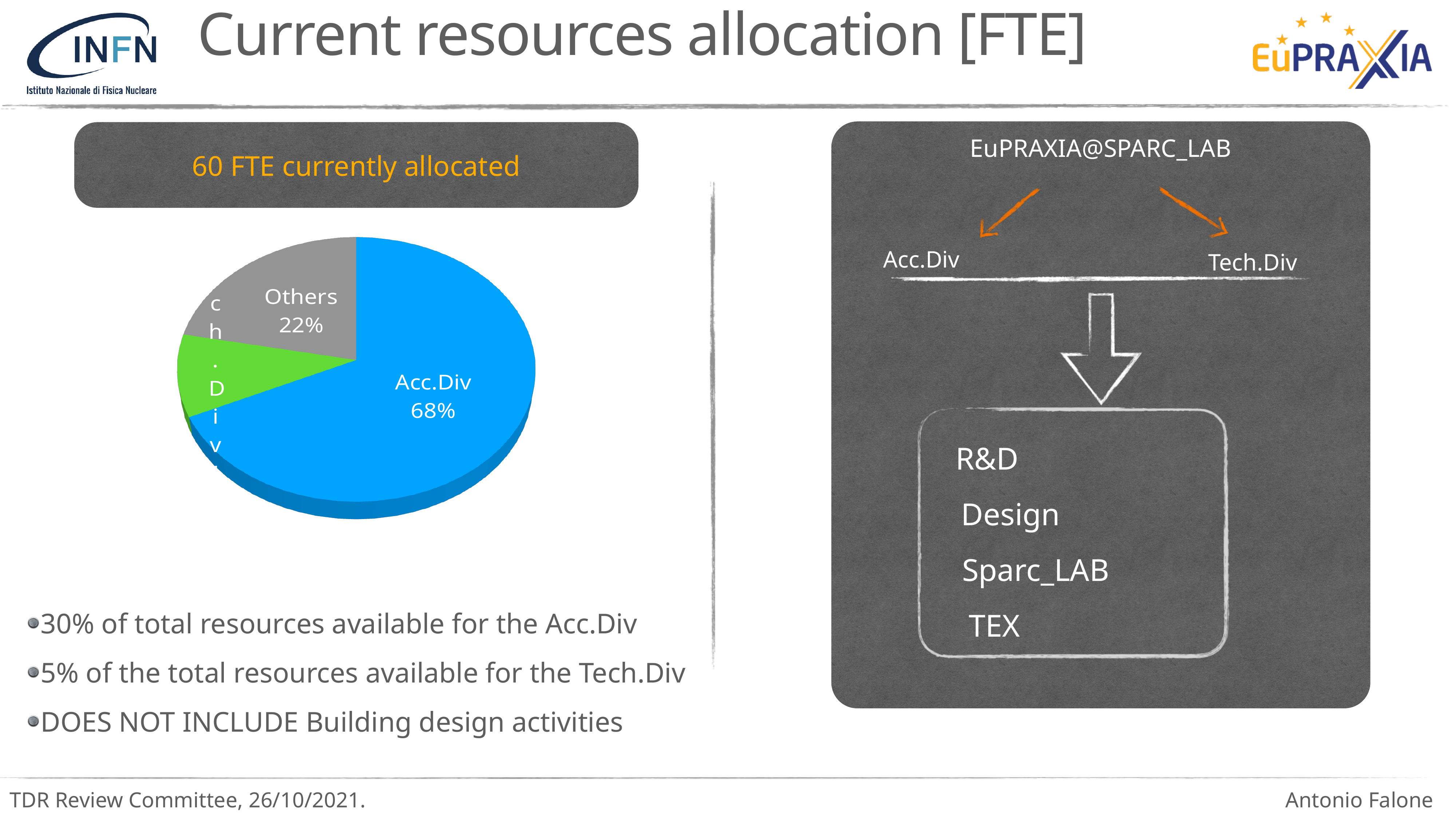
What kind of chart is shown on the slide? pie chart What text appears in the box above the pie chart? 60 FTE currently allocated How many slices does the pie chart have? 3 What share of the pie does Acc.Div account for? 68% Which slice of the pie chart is the smallest? Tech.Div What share of the pie does Others account for? 22% Which is larger in the pie chart, Acc.Div or Others? Acc.Div By how many percentage points does the Acc.Div share exceed the Others share? 46 Which slice of the pie chart is the largest? Acc.Div What colour is the Acc.Div slice of the pie chart? blue